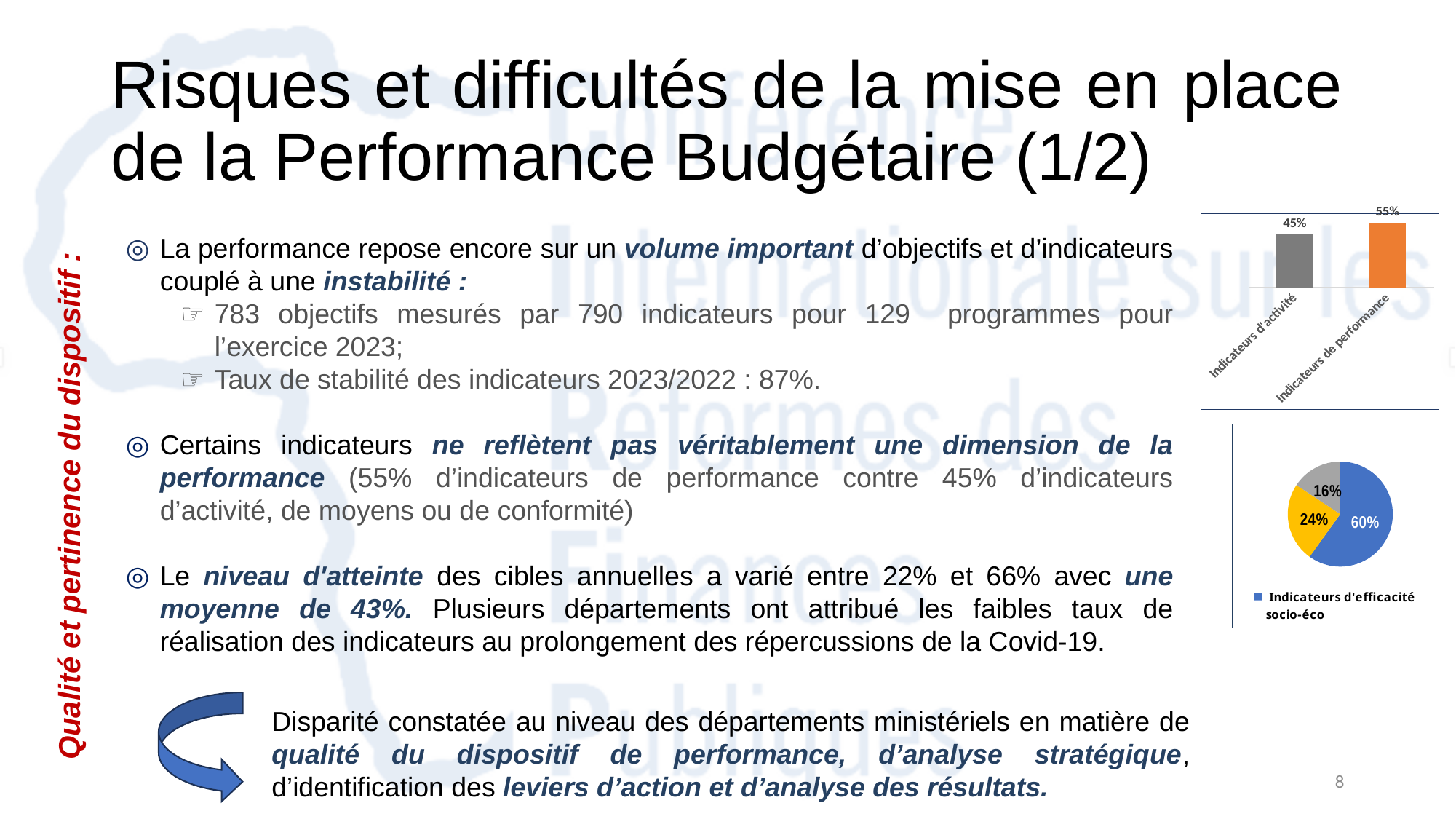
In the bar chart at the top right, what is the value for Indicateurs de performance? 55% In the pie chart at the bottom right, what is the share of the blue slice labelled Indicateurs d'efficacité socio-éco? 60% In the bar chart at the top right, how many categories are shown? 2 In the bar chart at the top right, which category has the highest value? Indicateurs de performance In the pie chart at the bottom right, how many slices are there? 3 In the pie chart at the bottom right, what is the largest slice's share? 60% What type of chart is shown at the top right of the slide? Bar chart In the bar chart at the top right, which category has the lowest value? Indicateurs d'activité In the bar chart at the top right, what is the value for Indicateurs d'activité? 45% What type of chart is shown at the bottom right of the slide? Pie chart In the pie chart at the bottom right, what is the smallest slice's share? 16% In the bar chart at the top right, what is the difference between Indicateurs de performance and Indicateurs d'activité? 10%